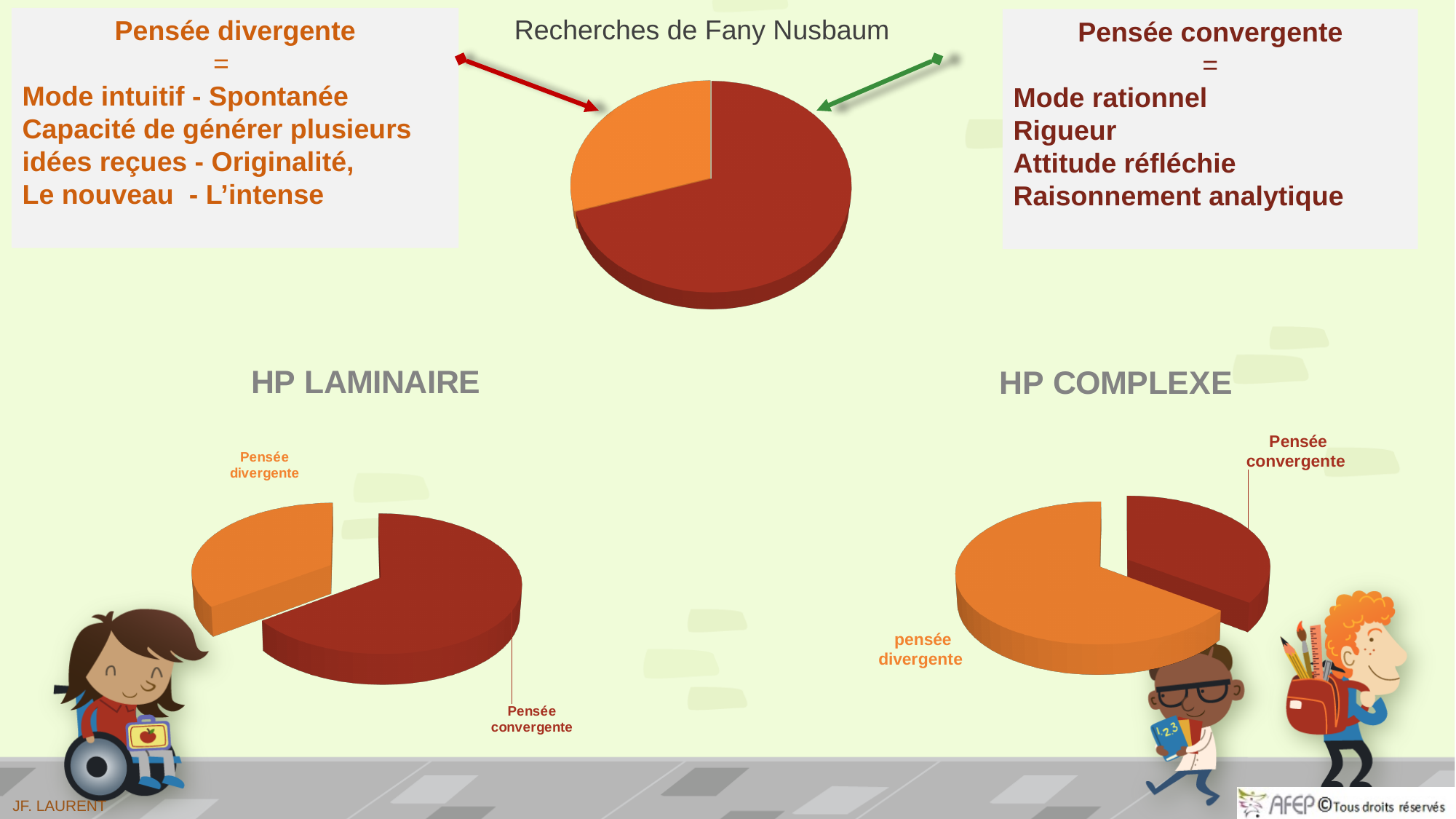
What is the title of the pie chart at the top centre of the slide? Recherches de Fany Nusbaum In the top pie chart titled "Recherches de Fany Nusbaum", which slice is larger: the orange one or the dark red one? The dark red one In the "HP LAMINAIRE" chart, which slice is the smallest? Pensée divergente How many slices does the "HP COMPLEXE" pie chart have? 2 In the "HP LAMINAIRE" chart, which slice is larger: Pensée divergente or Pensée convergente? Pensée convergente How many slices does the "HP LAMINAIRE" pie chart have? 2 In the "HP COMPLEXE" chart, which slice is larger: pensée divergente or Pensée convergente? pensée divergente In the "HP COMPLEXE" chart, which slice is the largest? pensée divergente What kind of chart is the "HP LAMINAIRE" chart? Pie chart What colour is the "Pensée convergente" slice in the "HP COMPLEXE" chart? Dark red What kind of chart is the "HP COMPLEXE" chart? Pie chart